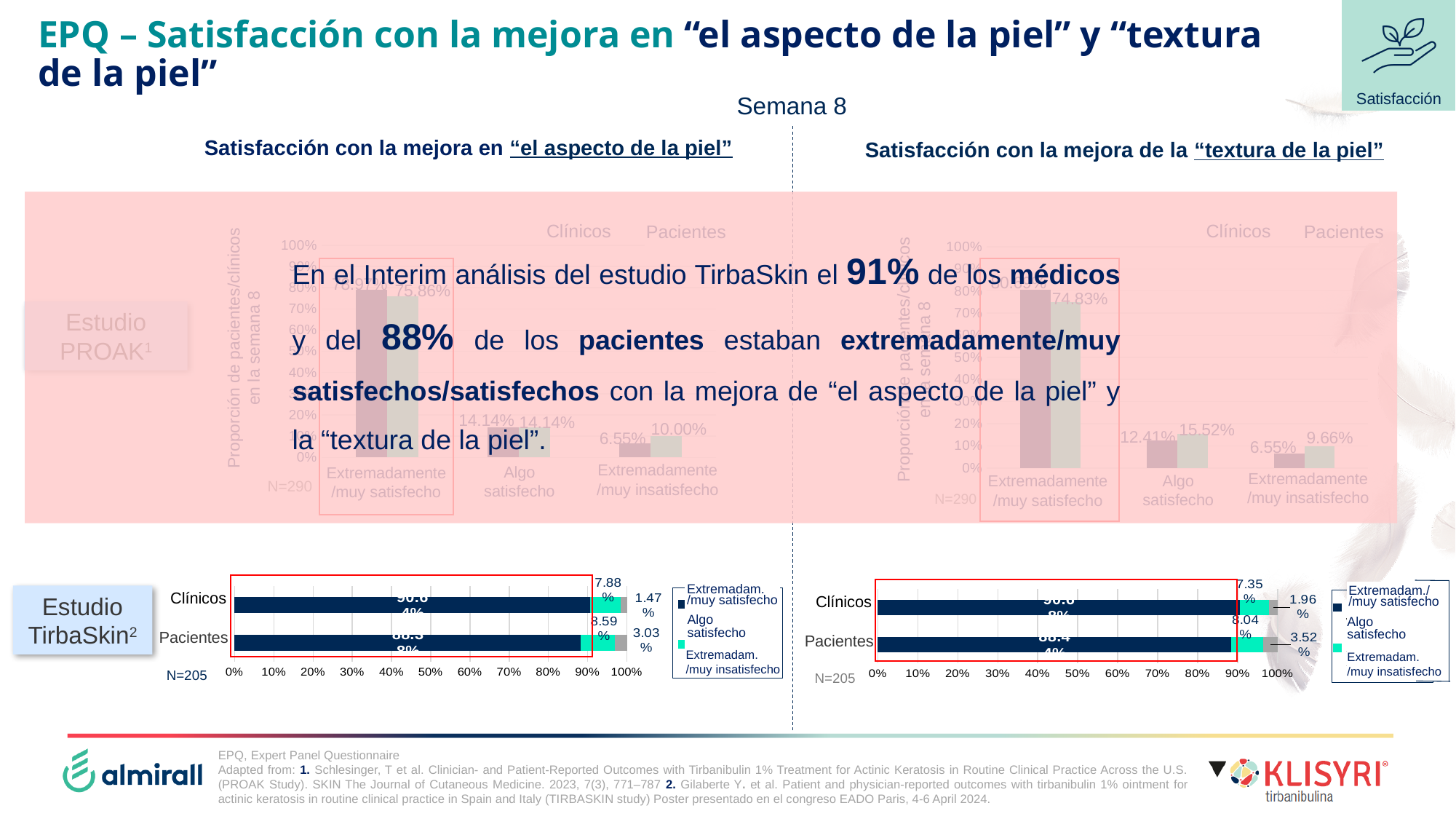
In the Estudio TirbaSkin "textura de la piel" chart, what is the Extremadam./muy insatisfecho value for Pacientes? 3.52% In the Estudio TirbaSkin "el aspecto de la piel" chart, what is the Extremadam./muy insatisfecho value for Clínicos? 1.47% In the Estudio PROAK "el aspecto de la piel" chart, what is the difference between the Pacientes and Clínicos values for Extremadamente/muy insatisfecho? 3.45% In the Estudio PROAK "textura de la piel" chart, what is the Pacientes value for Algo satisfecho? 15.52% How many series does the legend list for the Estudio TirbaSkin "el aspecto de la piel" chart? 3 In the Estudio PROAK "el aspecto de la piel" chart, what is the Pacientes value for Extremadamente/muy insatisfecho? 10.00% How many categories are shown on the x axis of the Estudio PROAK "el aspecto de la piel" chart? 3 In the Estudio TirbaSkin "textura de la piel" chart, what is the difference between the Algo satisfecho values for Pacientes and Clínicos? 0.69% In the Estudio TirbaSkin "el aspecto de la piel" chart, what is the Algo satisfecho value for Pacientes? 8.59% In the Estudio TirbaSkin "textura de la piel" chart, what is the Algo satisfecho value for Clínicos? 7.35% In the Estudio TirbaSkin "el aspecto de la piel" chart, which group has the larger Extremadam./muy insatisfecho value, Clínicos or Pacientes? Pacientes What kind of chart is the Estudio TirbaSkin chart for "el aspecto de la piel" at the bottom left of the slide? Bar chart